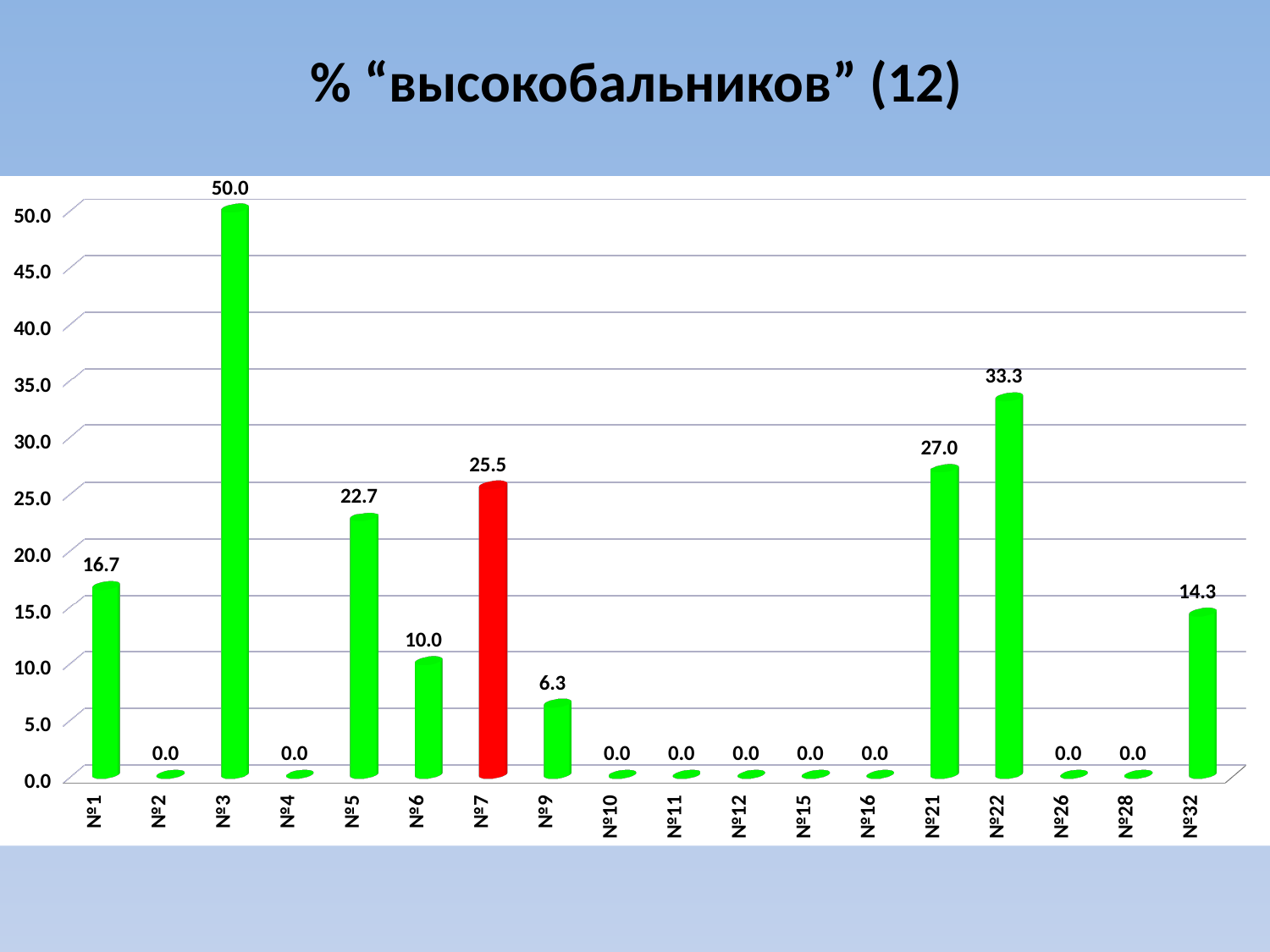
Which category has the highest value? №3 What is the value for №7? 25.5 Which is larger, the value for №7 or the value for №21? №21 What kind of chart is this? Bar chart How many categories have a value of 0.0? 9 What is the difference between the values for №3 and №22? 16.7 What is the value for №22? 33.3 What is the value for №32? 14.3 How many categories are shown on the x axis? 18 What is the difference between the values for №21 and №7? 1.5 What is the value for №3? 50.0 Is the value for №22 greater or less than 30.0? greater